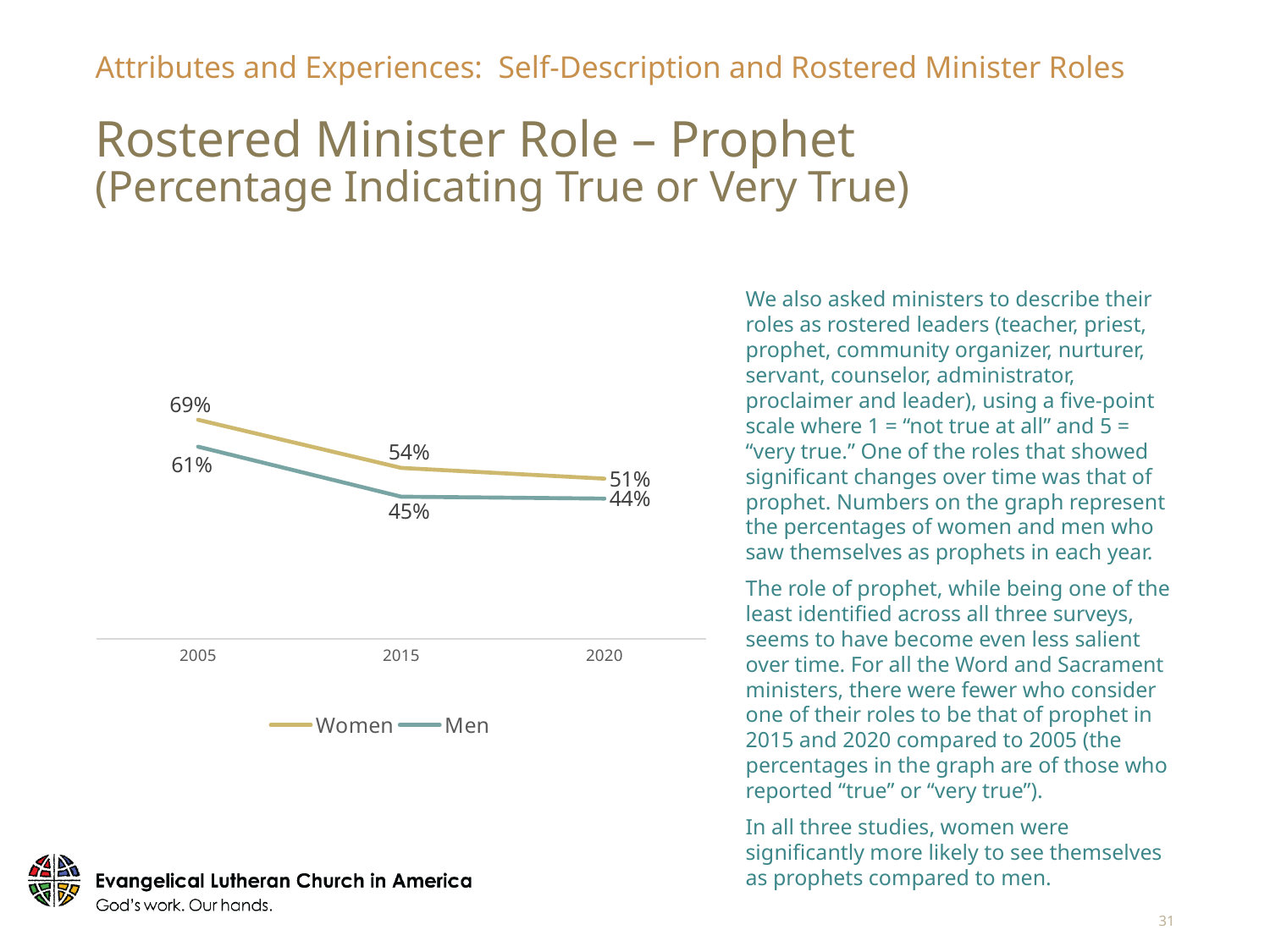
What is the difference between the Women and Men values in 2005? 8% In which year was the value for Women lowest? 2020 What percentage of women indicated the prophet role was true or very true in 2005? 69% What percentage of men indicated the prophet role was true or very true in 2015? 45% By how much did the Women value fall from 2005 to 2015? 15% Which series has the larger value in 2015, Women or Men? Women What is the value for Men in 2020? 44% What kind of chart is shown on the slide? Line chart What is the value for Women in 2020? 51% How many years are shown on the x axis? 3 How many series does the legend list? 2 In which year was the value for Men highest? 2005